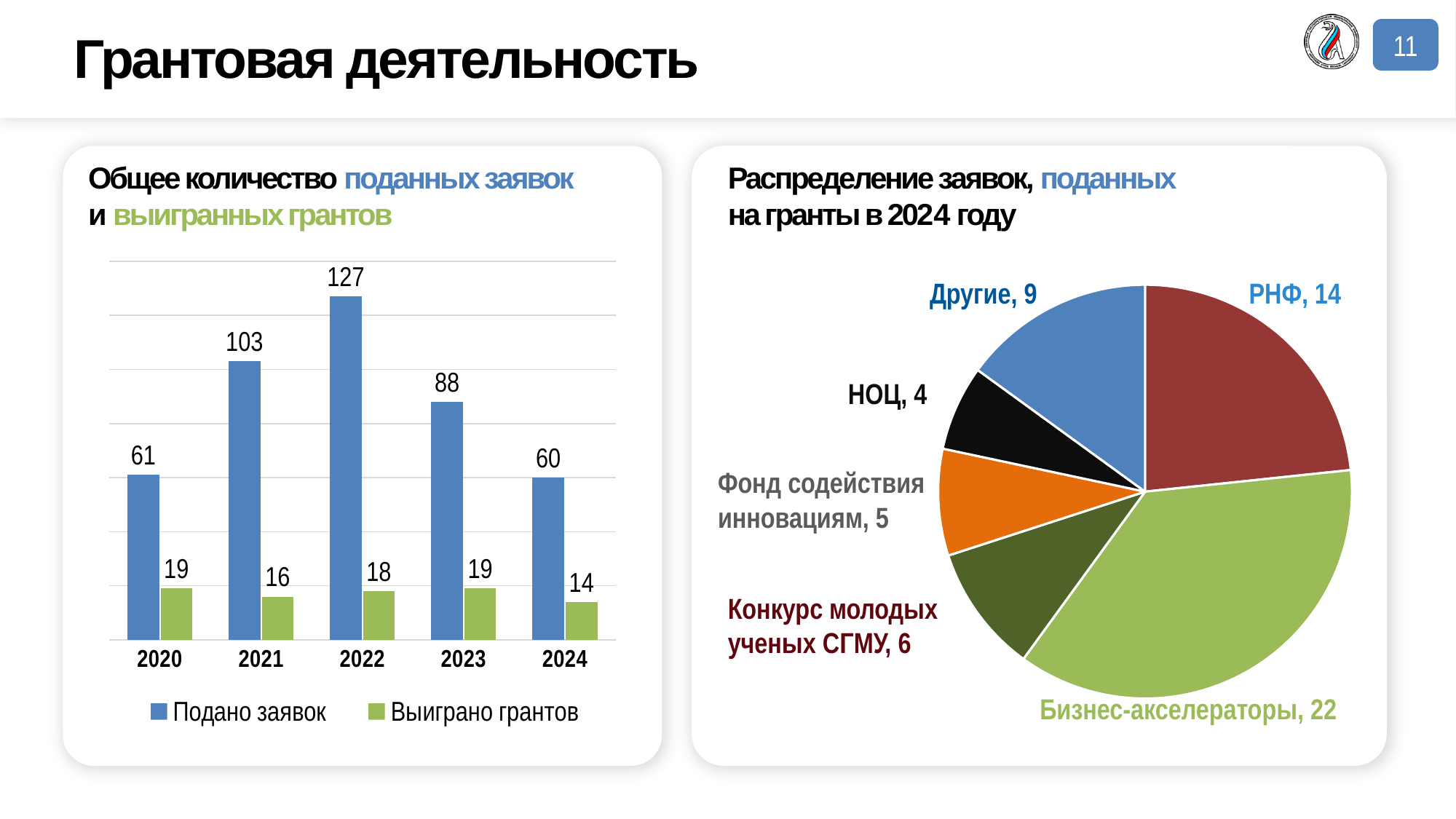
In the left bar chart, how many applications were submitted (Подано заявок) in 2022? 127 In the left bar chart, how many grants were won (Выиграно грантов) in 2024? 14 In the pie chart on the right, what is the total number of applications across all slices? 60 In the left bar chart, how many years are shown on the x axis? 5 In the left bar chart, how many series does the legend list? 2 What type of chart is shown on the right side of the slide? Pie chart In the left bar chart, which year has the lowest number of grants won? 2024 In the left bar chart, which year has the highest number of submitted applications? 2022 In the pie chart on the right, which is larger: РНФ or Другие? РНФ In the left bar chart, what is the difference between applications submitted in 2022 and in 2023? 39 In the pie chart on the right, which category has the smallest number of applications? НОЦ In the pie chart on the right, how many applications were submitted to Бизнес-акселераторы? 22